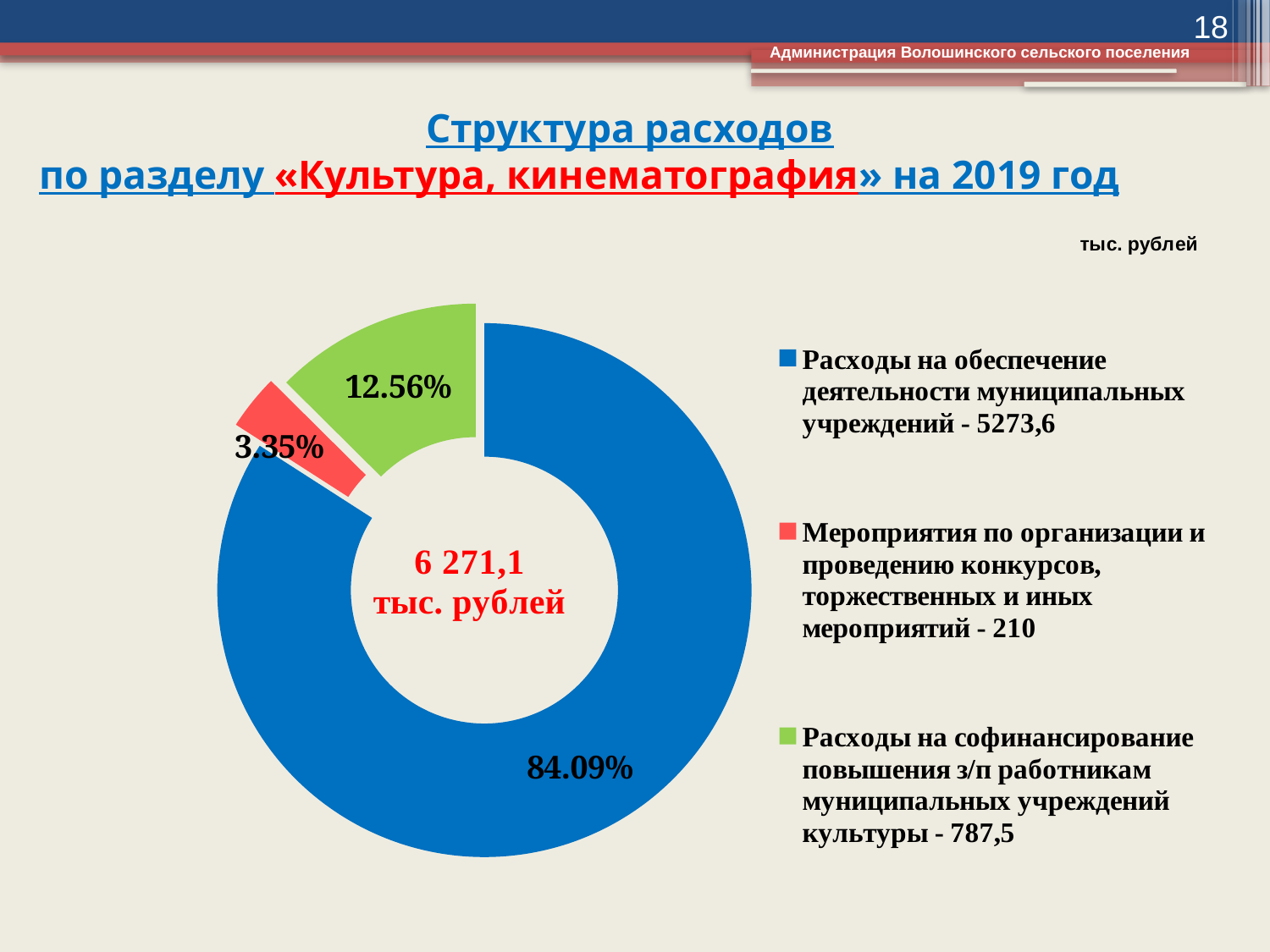
What is the value (тыс. рублей) shown in the legend for «Расходы на софинансирование повышения з/п работникам муниципальных учреждений культуры»? 787,5 What share of the chart does the slice for «Расходы на софинансирование повышения з/п работникам муниципальных учреждений культуры» represent? 12.56% What is the difference in percentage points between the largest slice (84.09%) and the green slice (12.56%)? 71.53 What is the value (тыс. рублей) shown in the legend for «Расходы на обеспечение деятельности муниципальных учреждений»? 5273,6 Which category has the largest share of the chart? Расходы на обеспечение деятельности муниципальных учреждений How many categories does the chart show? 3 What is the total amount shown in the centre of the chart? 6 271,1 тыс. рублей What share of the chart does the slice for «Мероприятия по организации и проведению конкурсов, торжественных и иных мероприятий» represent? 3.35% What share of the chart does the slice for «Расходы на обеспечение деятельности муниципальных учреждений» represent? 84.09% What is the value (тыс. рублей) shown in the legend for «Мероприятия по организации и проведению конкурсов, торжественных и иных мероприятий»? 210 What kind of chart is shown on the slide? doughnut (pie) chart Which category has the smallest share of the chart? Мероприятия по организации и проведению конкурсов, торжественных и иных мероприятий